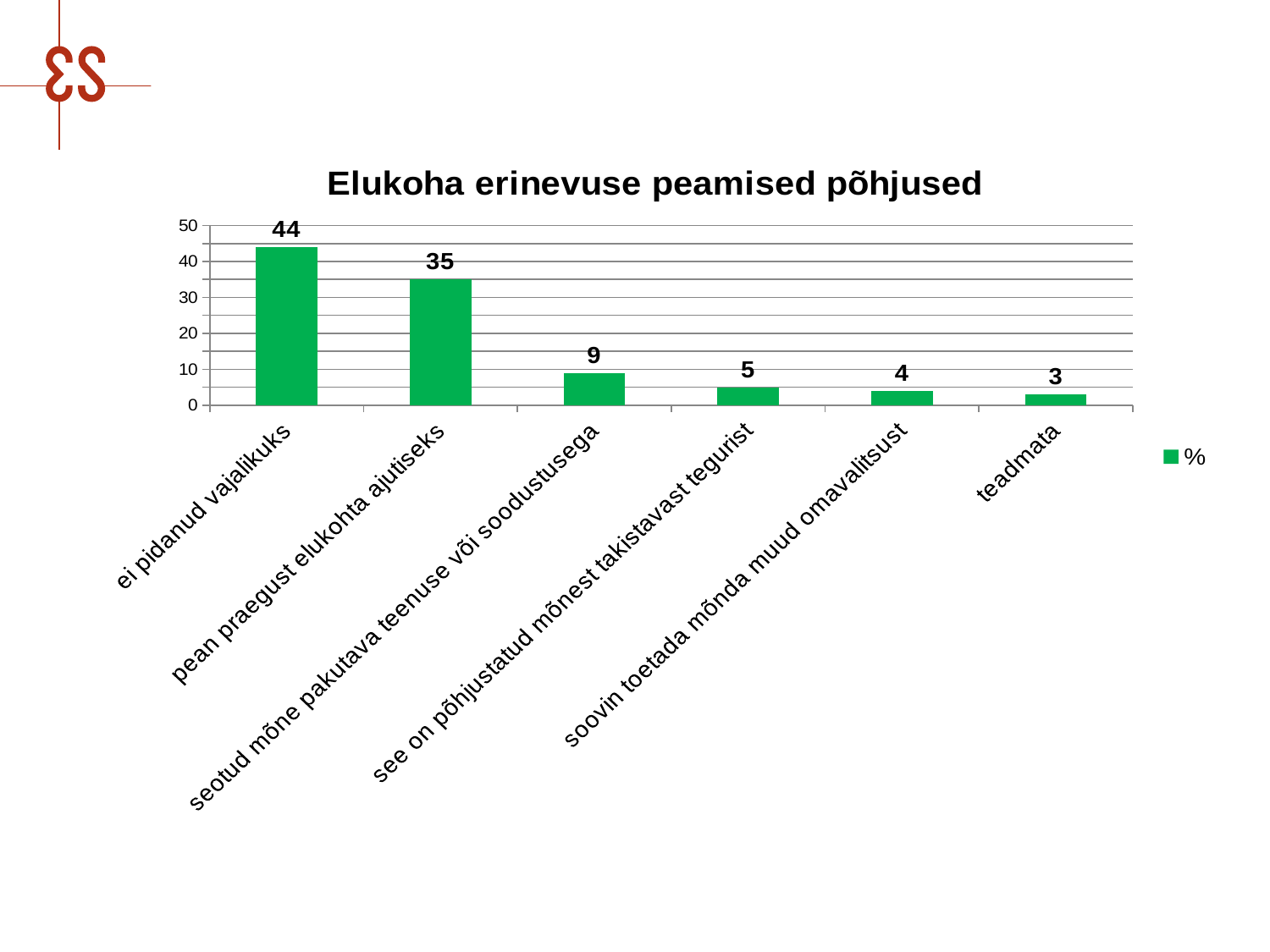
What is the value for "ei pidanud vajalikuks"? 44 Which category has the highest value? ei pidanud vajalikuks What is the title of the chart? Elukoha erinevuse peamised põhjused How many series does the legend list? 1 What is the value for "seotud mõne pakutava teenuse või soodustusega"? 9 Which category has the lowest value? teadmata Which is larger: the value for "see on põhjustatud mõnest takistavast tegurist" or the value for "soovin toetada mõnda muud omavalitsust"? see on põhjustatud mõnest takistavast tegurist What is the value for "pean praegust elukohta ajutiseks"? 35 How many categories are shown on the x axis? 6 What is the value for "teadmata"? 3 What kind of chart is shown on the slide? bar chart What is the difference between the values for "ei pidanud vajalikuks" and "pean praegust elukohta ajutiseks"? 9